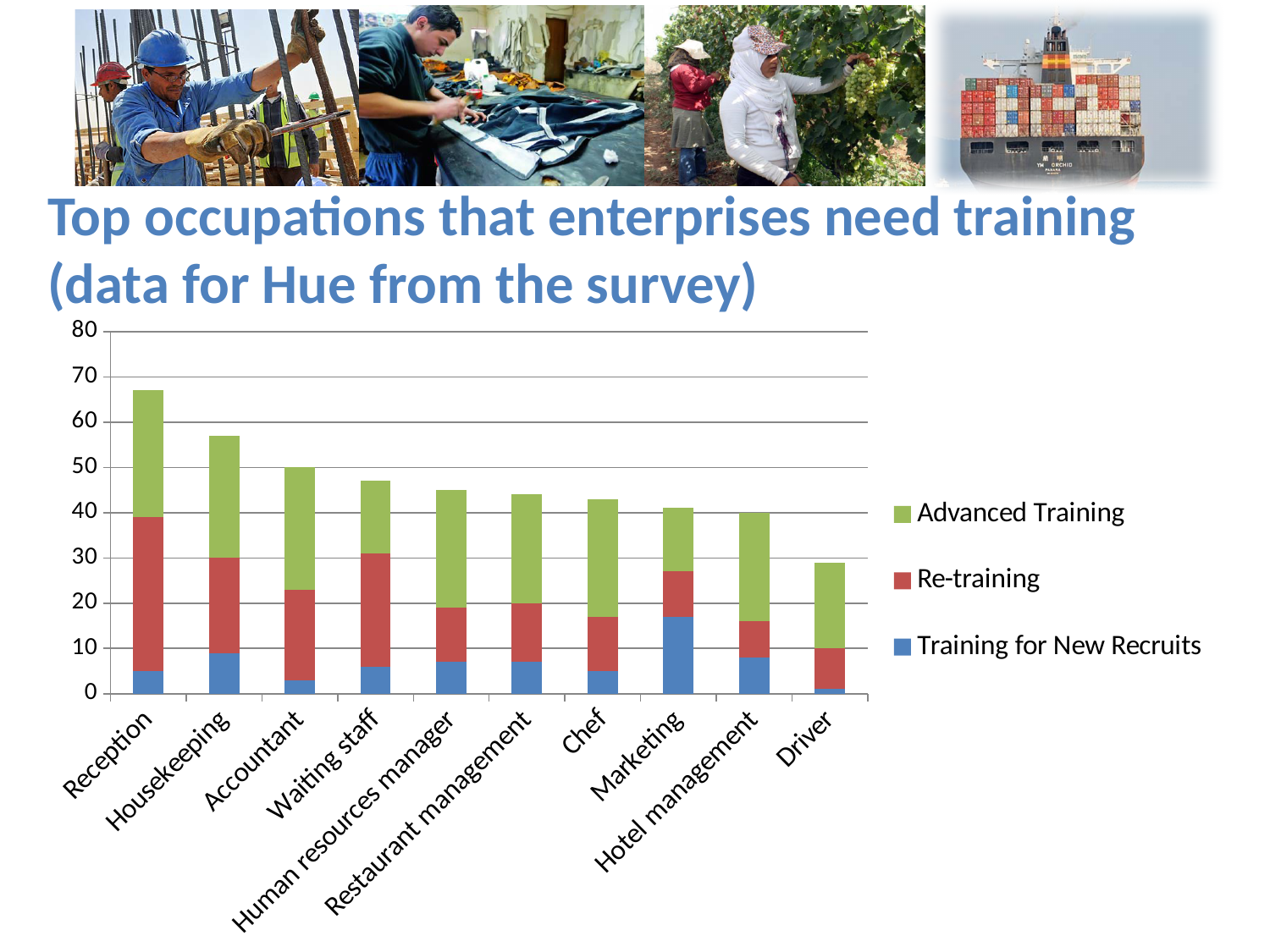
Which series is shown in green in the legend? Advanced Training Do the total bar heights rise or fall from left to right along the x axis? fall Which occupation has the lowest total bar? Driver How many series does the legend list? 3 What kind of chart is shown on the slide? stacked bar chart Which has a larger total bar, Housekeeping or Chef? Housekeeping Which occupation has the highest total bar? Reception Is the Training for New Recruits value for Marketing greater or less than 10? greater Is the total value for Housekeeping greater or less than 50? greater How many occupations are shown on the x axis? 10 Is the total value for Reception greater or less than 60? greater